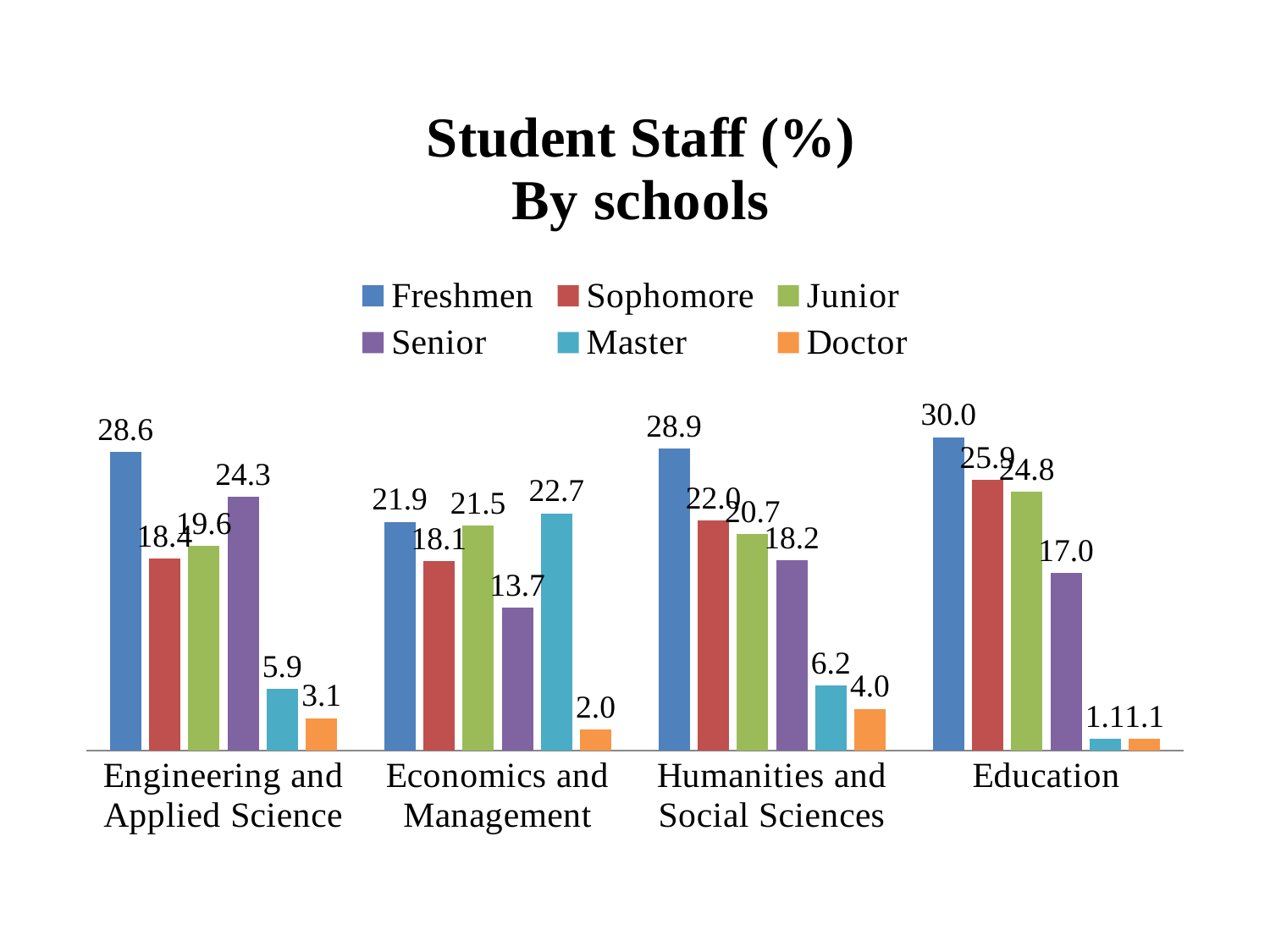
What is the Master value for Economics and Management? 22.7 Which school has the highest Freshmen value? Education What kind of chart is shown on the slide? Bar chart For Economics and Management, which is larger: the Master value or the Senior value? Master How many series does the legend list? 6 What is the Senior value for Engineering and Applied Science? 24.3 What is the difference between the Freshmen and Sophomore values for Engineering and Applied Science? 10.2 What is the Doctor value for Economics and Management? 2.0 What is the difference between the Senior values for Engineering and Applied Science and Economics and Management? 10.6 How many schools are shown on the x axis? 4 What is the Freshmen value for Education? 30.0 Which school has the lowest Senior value? Economics and Management